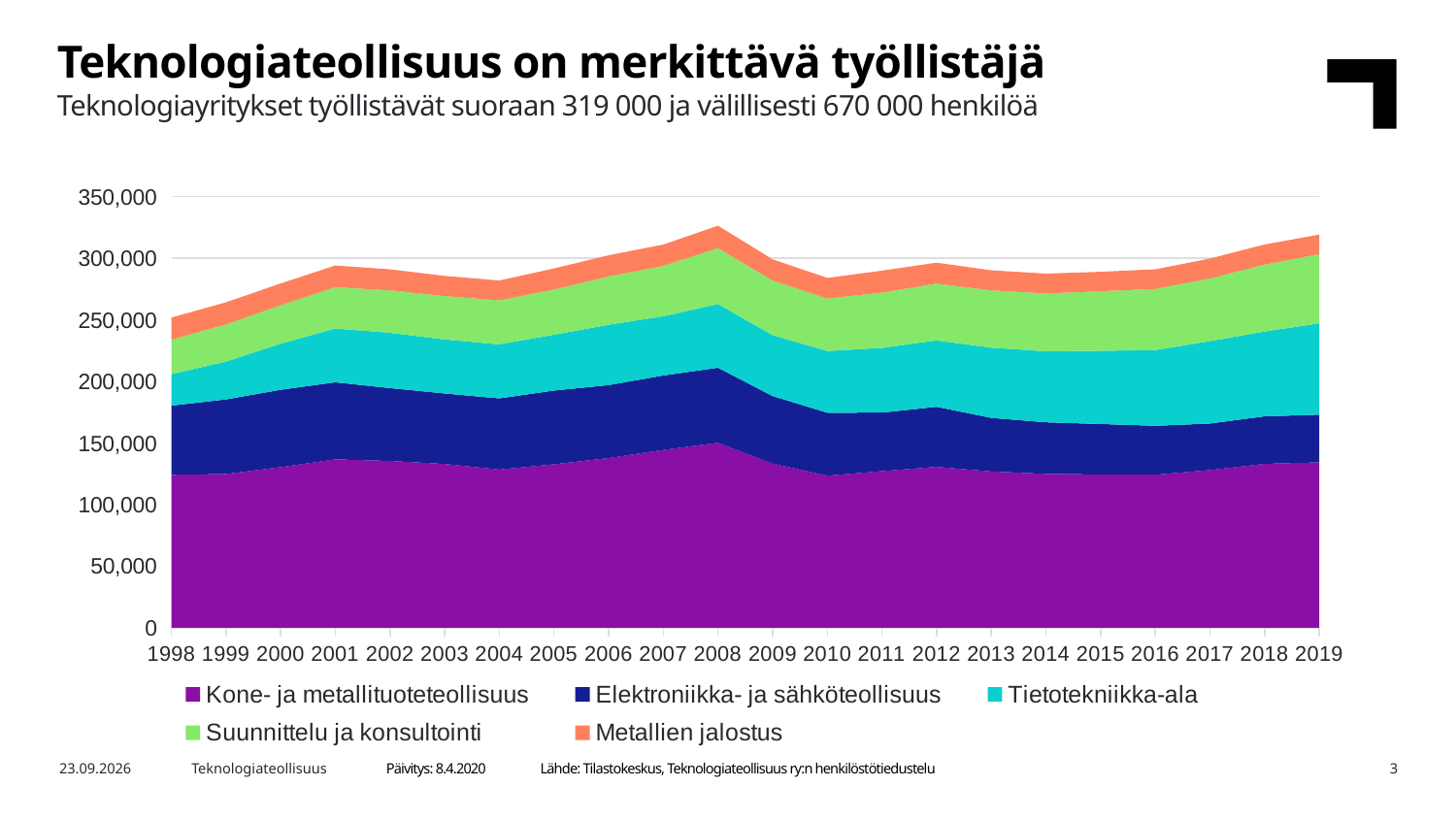
Which series is plotted at the bottom of the stack? Kone- ja metallituoteteollisuus Which year has the highest total employment across all series? 2008 Is the total value for 2008 greater or less than 300,000? greater Which year has the lowest total employment across all series? 1998 Does the total employment rise or fall from 2008 to 2010? Fall What kind of chart is shown on the slide? Stacked area chart Which year has the larger total employment, 2008 or 2010? 2008 Is the value for Kone- ja metallituoteteollisuus in 1998 greater or less than 150,000? less How many series does the legend list? 5 How many years are shown along the x axis? 22 Is the total value for 1998 greater or less than 300,000? less Which series is shown in orange in the legend? Metallien jalostus